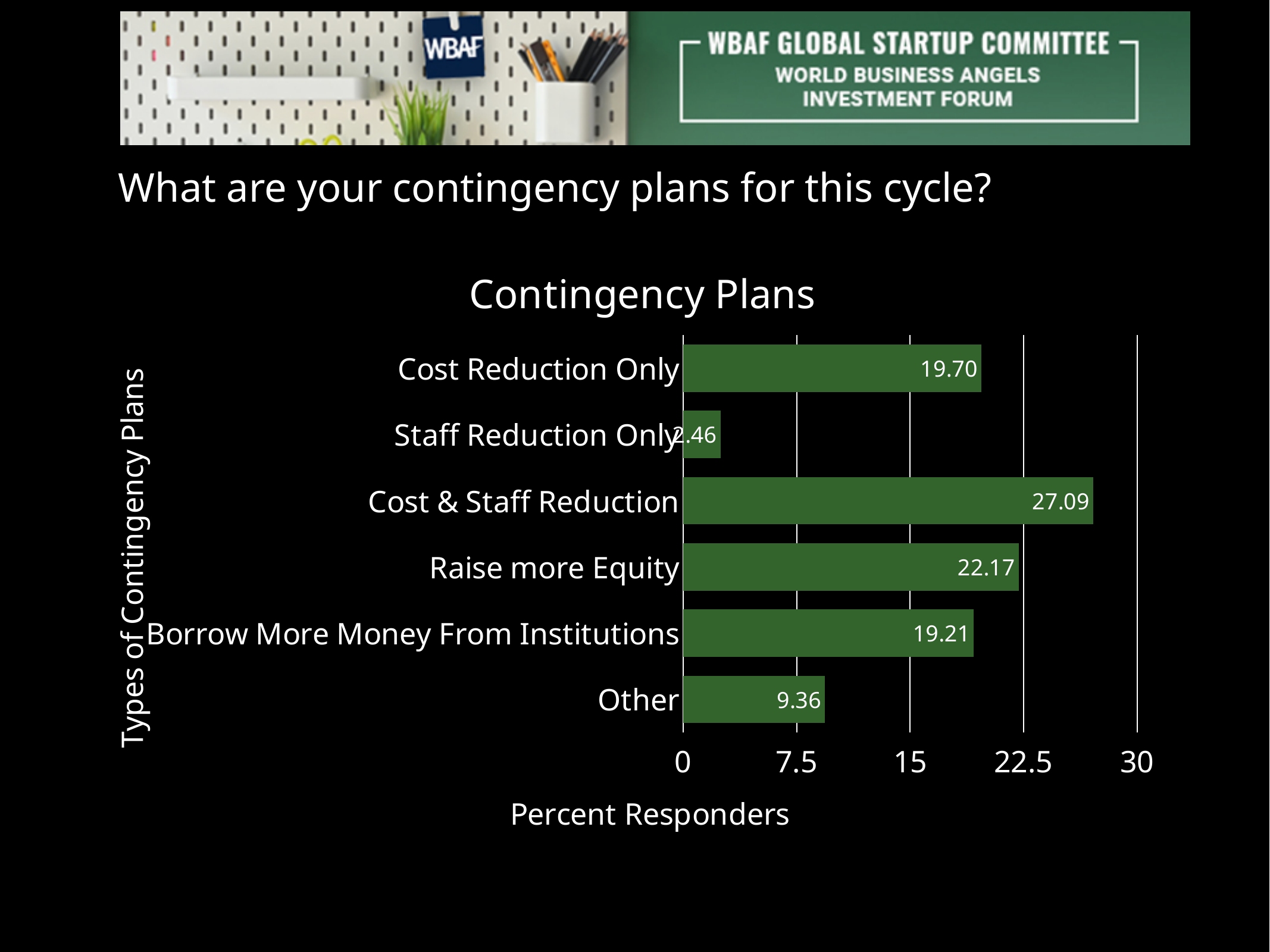
Which contingency plan has the lowest percent of responders? Staff Reduction Only Is the value for Cost Reduction Only greater or less than 15? greater What is the value for Borrow More Money From Institutions? 19.21 What is the value for Other? 9.36 What type of chart is shown on the slide? bar chart What is the difference between Raise more Equity and Other? 12.81 What is the value for Staff Reduction Only? 2.46 What is the value for Cost & Staff Reduction? 27.09 Which is larger, Raise more Equity or Cost Reduction Only? Raise more Equity What is the difference between Cost & Staff Reduction and Raise more Equity? 4.92 How many contingency plan categories are shown in the chart? 6 Which contingency plan has the highest percent of responders? Cost & Staff Reduction